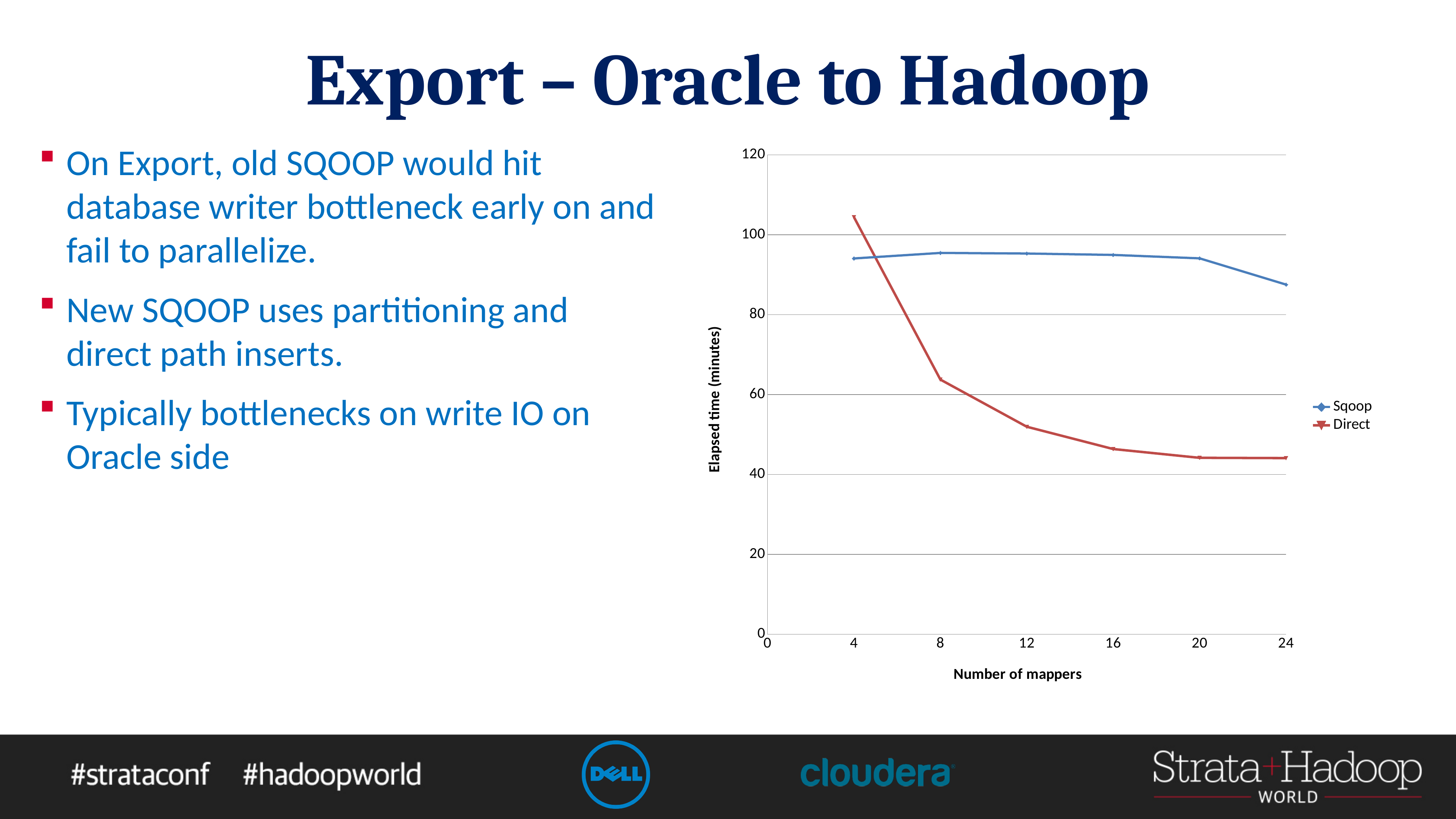
Does the elapsed time for the Direct series rise or fall as the number of mappers increases? fall Is the elapsed time for Direct at 24 mappers greater or less than 60 minutes? less Is the elapsed time for Sqoop at 12 mappers greater or less than 80 minutes? greater At which number of mappers is the elapsed time for the Sqoop series lowest? 24 At 16 mappers, which series has the higher elapsed time, Sqoop or Direct? Sqoop How many series does the legend list? 2 What is the title of the chart's y axis? Elapsed time (minutes) Is the elapsed time for Sqoop at 24 mappers greater or less than 100 minutes? less At which number of mappers is the elapsed time for the Direct series highest? 4 How many data points are plotted for the Direct series? 6 What kind of chart is shown on the slide? line chart